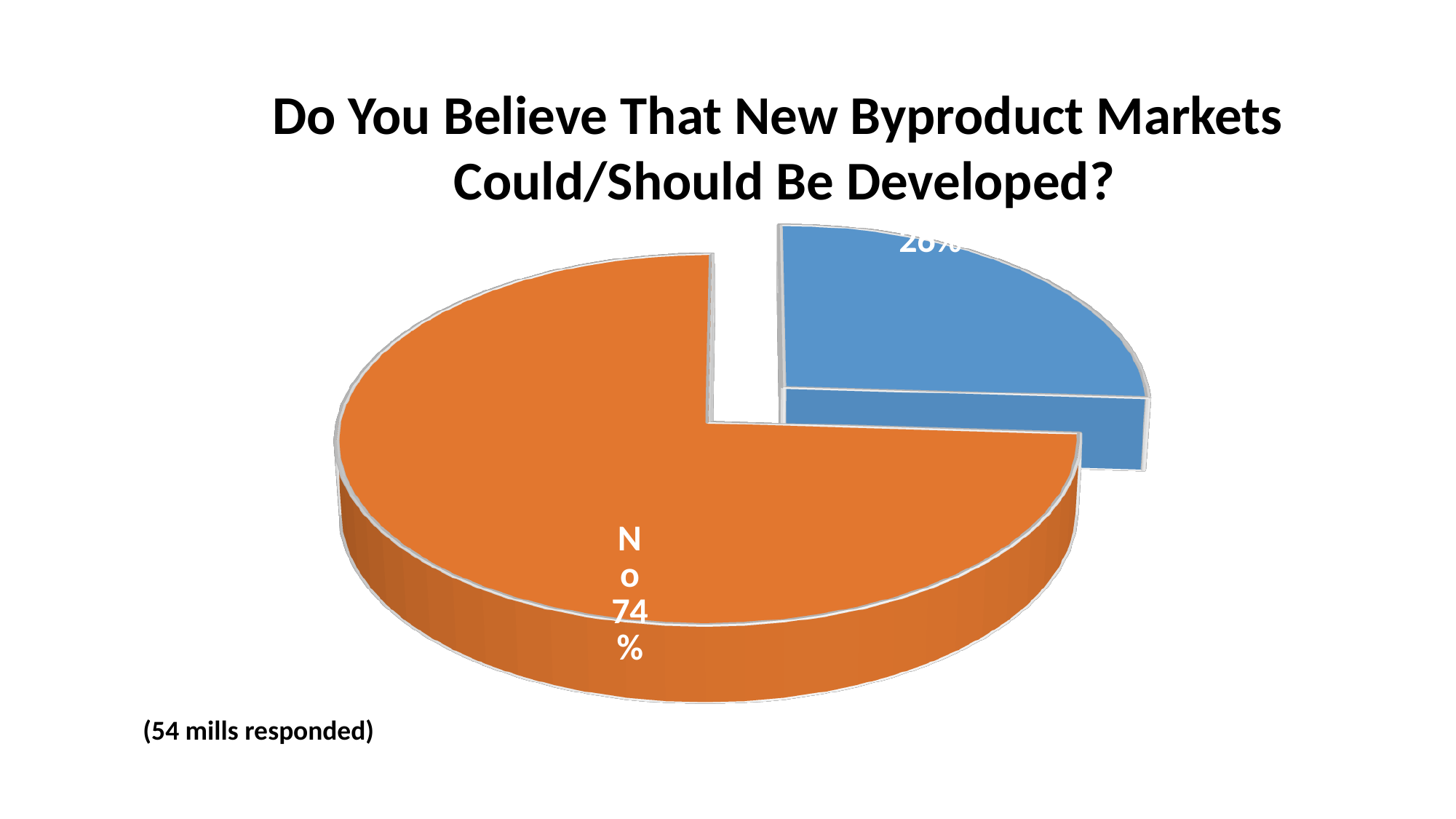
What is the title of the chart? Do You Believe That New Byproduct Markets Could/Should Be Developed? What share of the pie does the "No" slice represent? 74% Which is larger, the orange slice or the blue slice? the orange slice How many slices does the pie chart have? 2 According to the note on the slide, how many mills responded? 54 Which slice of the pie is the largest? No What colour is the "No" slice of the pie? orange Is the share for "No" greater or less than 50%? greater What kind of chart is shown on the slide? pie chart